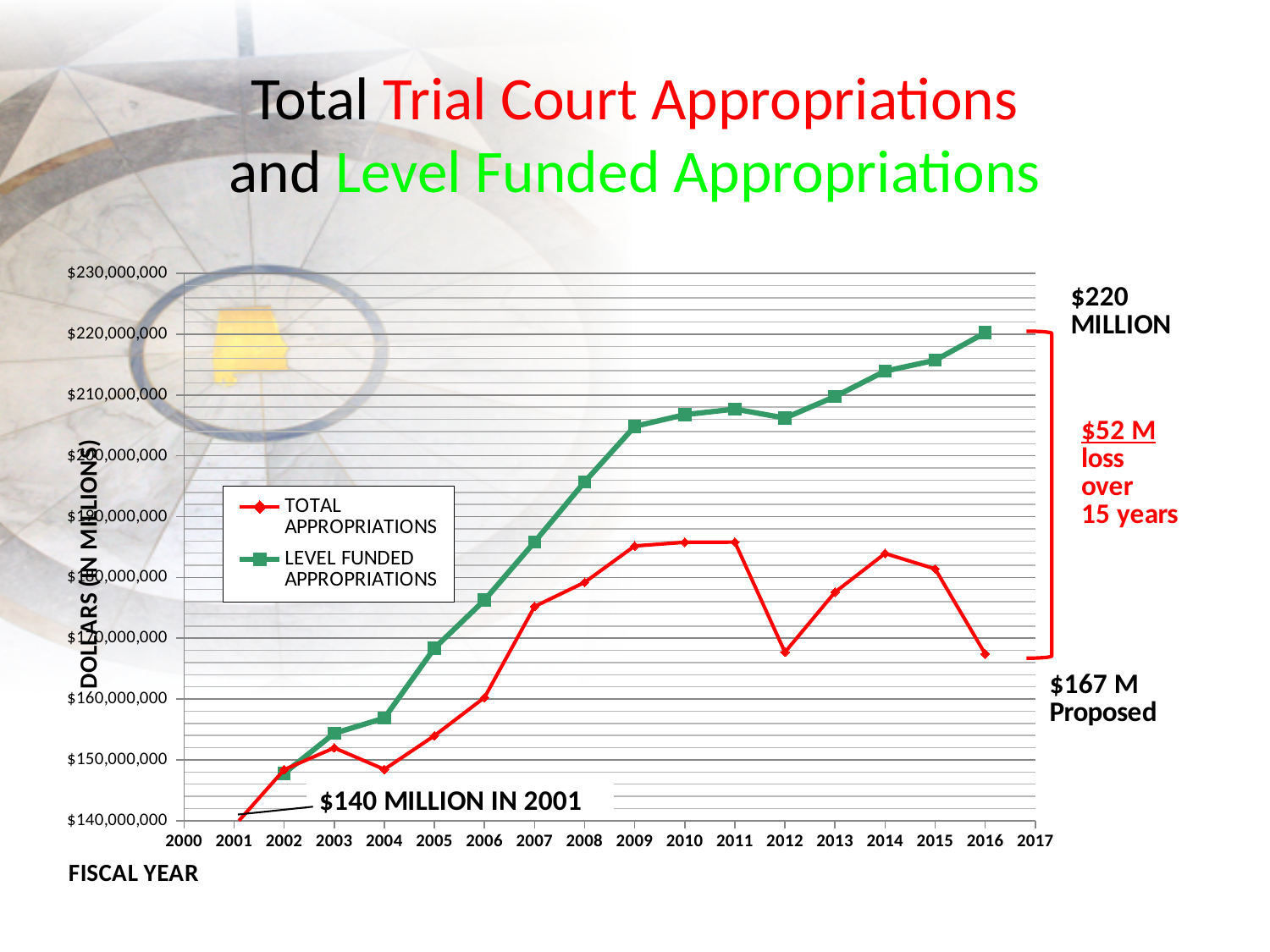
According to the annotation, what is the proposed TOTAL APPROPRIATIONS value for 2016? $167 M Does the LEVEL FUNDED APPROPRIATIONS line generally rise or fall from 2002 to 2016? rise What are the two series named in the legend? TOTAL APPROPRIATIONS and LEVEL FUNDED APPROPRIATIONS What kind of chart is shown on the slide? line chart Is the TOTAL APPROPRIATIONS value for 2012 greater or less than $180,000,000? less In 2016, which series has the larger value, TOTAL APPROPRIATIONS or LEVEL FUNDED APPROPRIATIONS? LEVEL FUNDED APPROPRIATIONS What colour is the LEVEL FUNDED APPROPRIATIONS line? green According to the annotation, what is the LEVEL FUNDED APPROPRIATIONS value in 2016? $220 million Is the LEVEL FUNDED APPROPRIATIONS value for 2009 greater or less than $200,000,000? greater According to the annotation, what was the value of TOTAL APPROPRIATIONS in 2001? $140 million In which fiscal year is TOTAL APPROPRIATIONS at its lowest? 2001 How many series does the legend list? 2